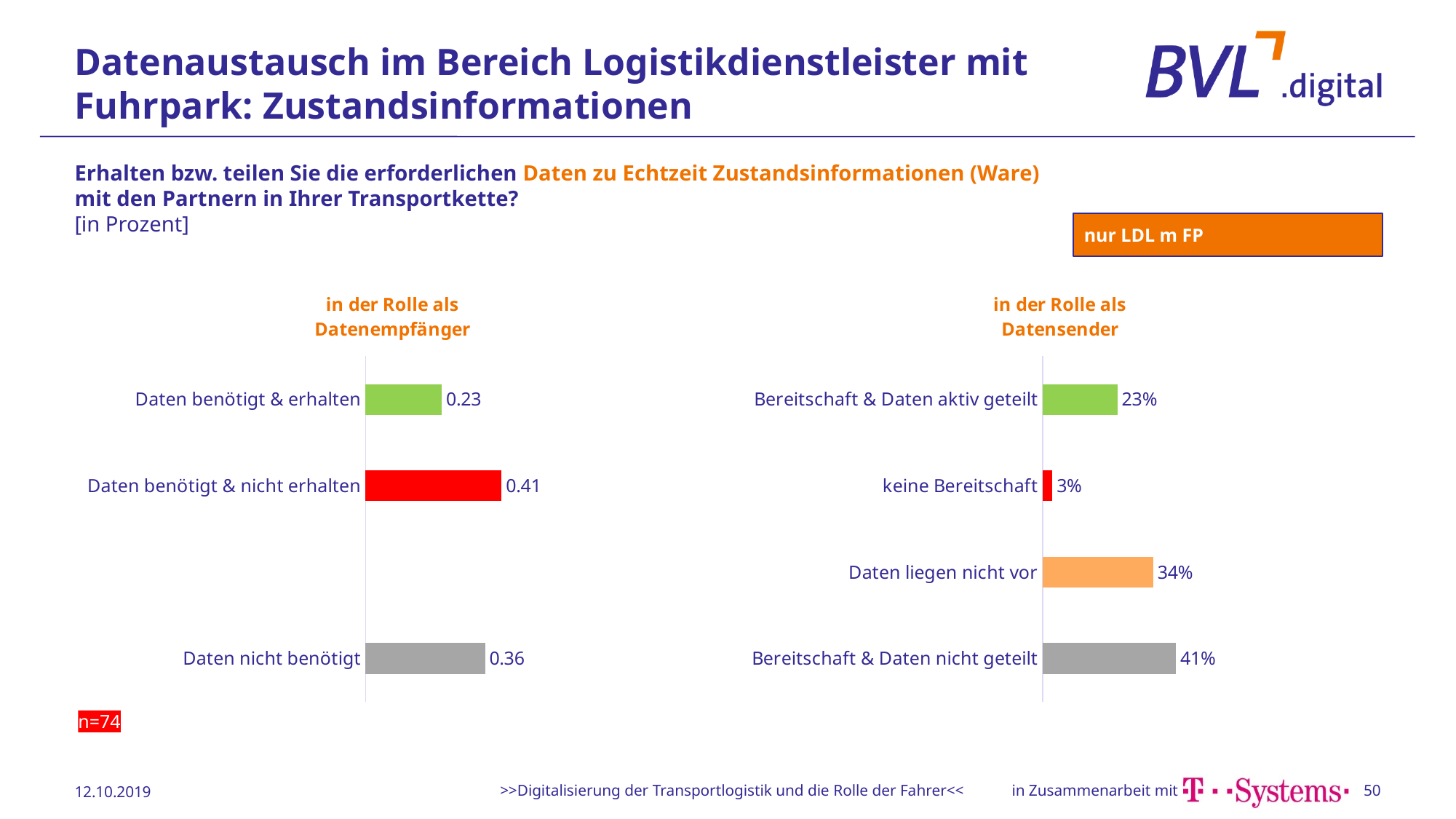
In the 'in der Rolle als Datenempfänger' chart, what is the value for 'Daten benötigt & nicht erhalten'? 0.41 In the 'in der Rolle als Datensender' chart, which is larger: 'Bereitschaft & Daten aktiv geteilt' or 'Daten liegen nicht vor'? Daten liegen nicht vor How many categories are shown in the 'in der Rolle als Datensender' chart? 4 In the 'in der Rolle als Datenempfänger' chart, which category has the highest value? Daten benötigt & nicht erhalten In the 'in der Rolle als Datensender' chart, what is the difference between 'Bereitschaft & Daten nicht geteilt' and 'Daten liegen nicht vor'? 7% In the 'in der Rolle als Datensender' chart, which category has the highest value? Bereitschaft & Daten nicht geteilt What kind of chart is the 'in der Rolle als Datenempfänger' chart? Bar chart In the 'in der Rolle als Datensender' chart, what is the value for 'Daten liegen nicht vor'? 34% In the 'in der Rolle als Datenempfänger' chart, what is the difference between 'Daten benötigt & nicht erhalten' and 'Daten benötigt & erhalten'? 0.18 In the 'in der Rolle als Datensender' chart, which category has the lowest value? keine Bereitschaft In the 'in der Rolle als Datensender' chart, what is the value for 'keine Bereitschaft'? 3% In the 'in der Rolle als Datenempfänger' chart, what is the value for 'Daten nicht benötigt'? 0.36